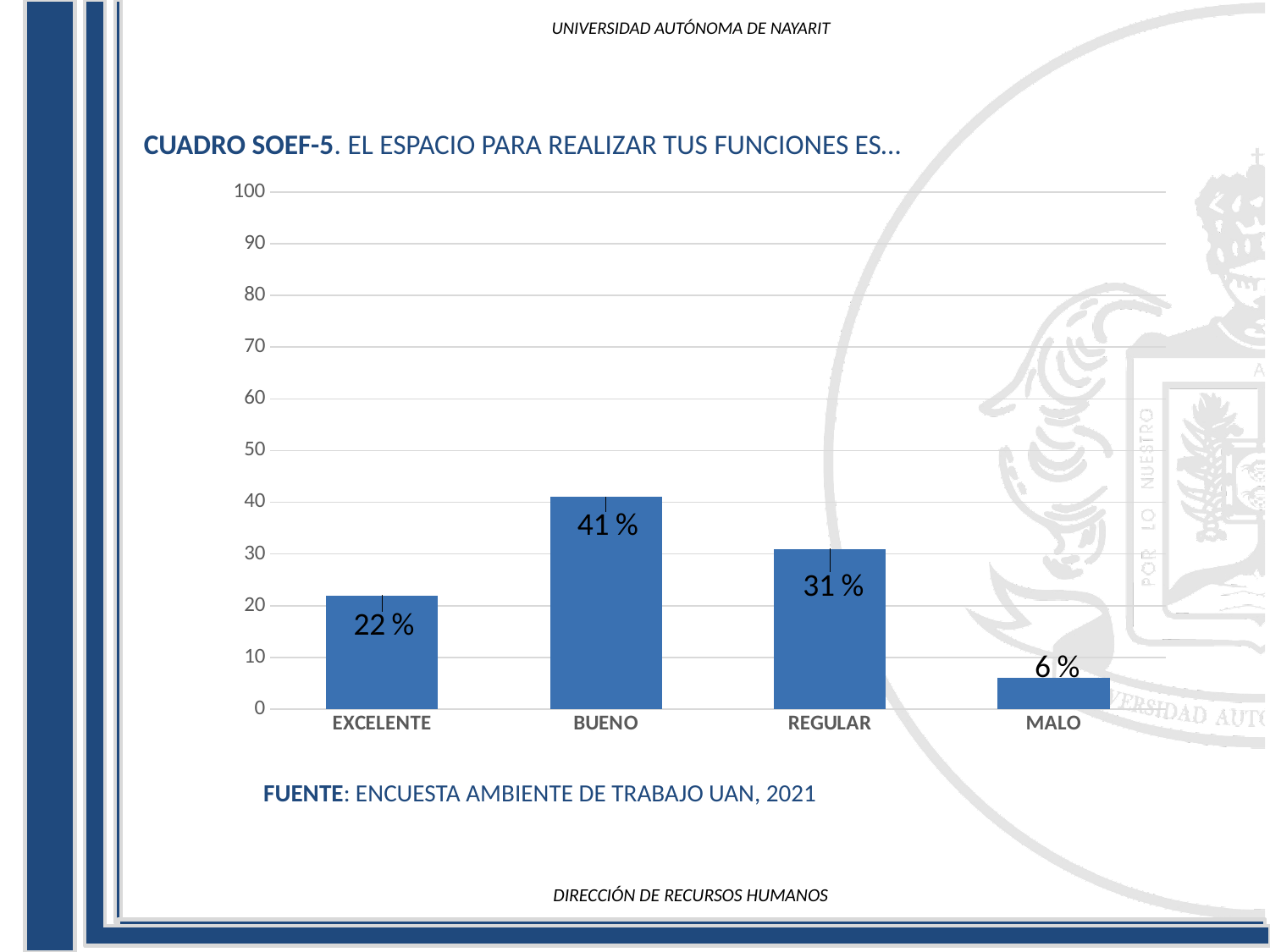
What kind of chart is shown on the slide? bar chart How many categories are shown on the x axis? 4 Which is larger, the value for EXCELENTE or the value for REGULAR? REGULAR What is the difference between the values for BUENO and REGULAR? 10 % What is the value for MALO? 6 % Which category has the highest value? BUENO What is the value for REGULAR? 31 % Which category has the lowest value? MALO Is the value for REGULAR greater or less than 40? less What is the value for EXCELENTE? 22 % What is the value for BUENO? 41 % What is the source cited below the chart? ENCUESTA AMBIENTE DE TRABAJO UAN, 2021